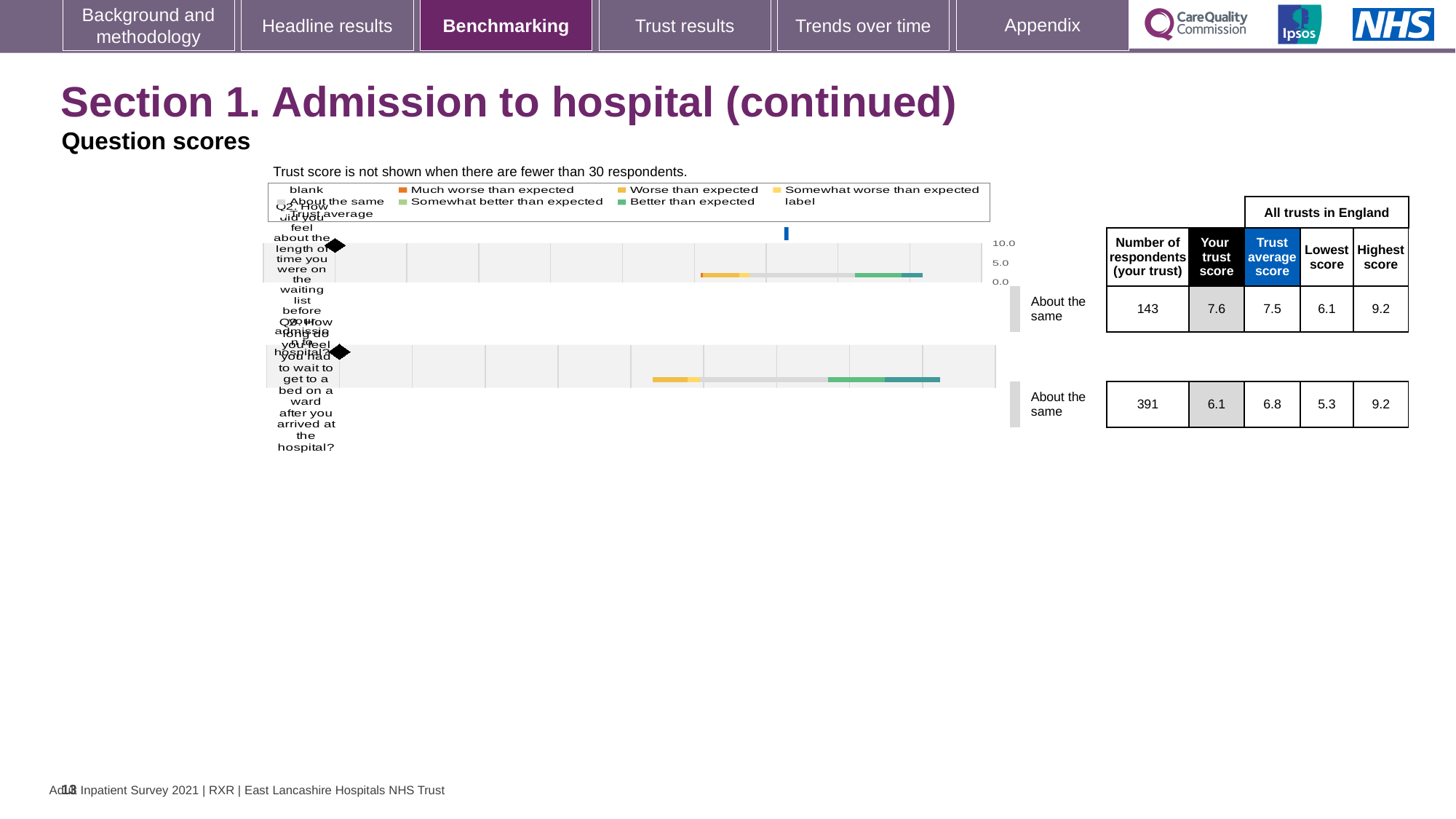
In the Q2 chart (length of time on the waiting list), which is larger: your trust score or the trust average score? Your trust score What benchmark category is shown next to the Q3 chart (wait to get to a bed on a ward)? About the same In the Q2 chart (length of time on the waiting list), how many respondents does the table show for your trust? 143 In the Q2 chart (length of time on the waiting list), what is the trust average score for all trusts in England? 7.5 In the Q2 chart (length of time on the waiting list), what is your trust score? 7.6 In the Q3 chart (wait to get to a bed on a ward), what is the lowest score among all trusts in England? 5.3 What kind of chart is used to show the question scores on this slide? Bar chart In the Q3 chart (wait to get to a bed on a ward), how many respondents does the table show for your trust? 391 In the Q3 chart (wait to get to a bed on a ward), which is larger: your trust score or the trust average score? Trust average score In the Q3 chart (wait to get to a bed on a ward), what is your trust score? 6.1 In the Q3 chart (wait to get to a bed on a ward), what is the difference between the highest score and the lowest score? 3.9 In the Q2 chart (length of time on the waiting list), what is the highest score among all trusts in England? 9.2